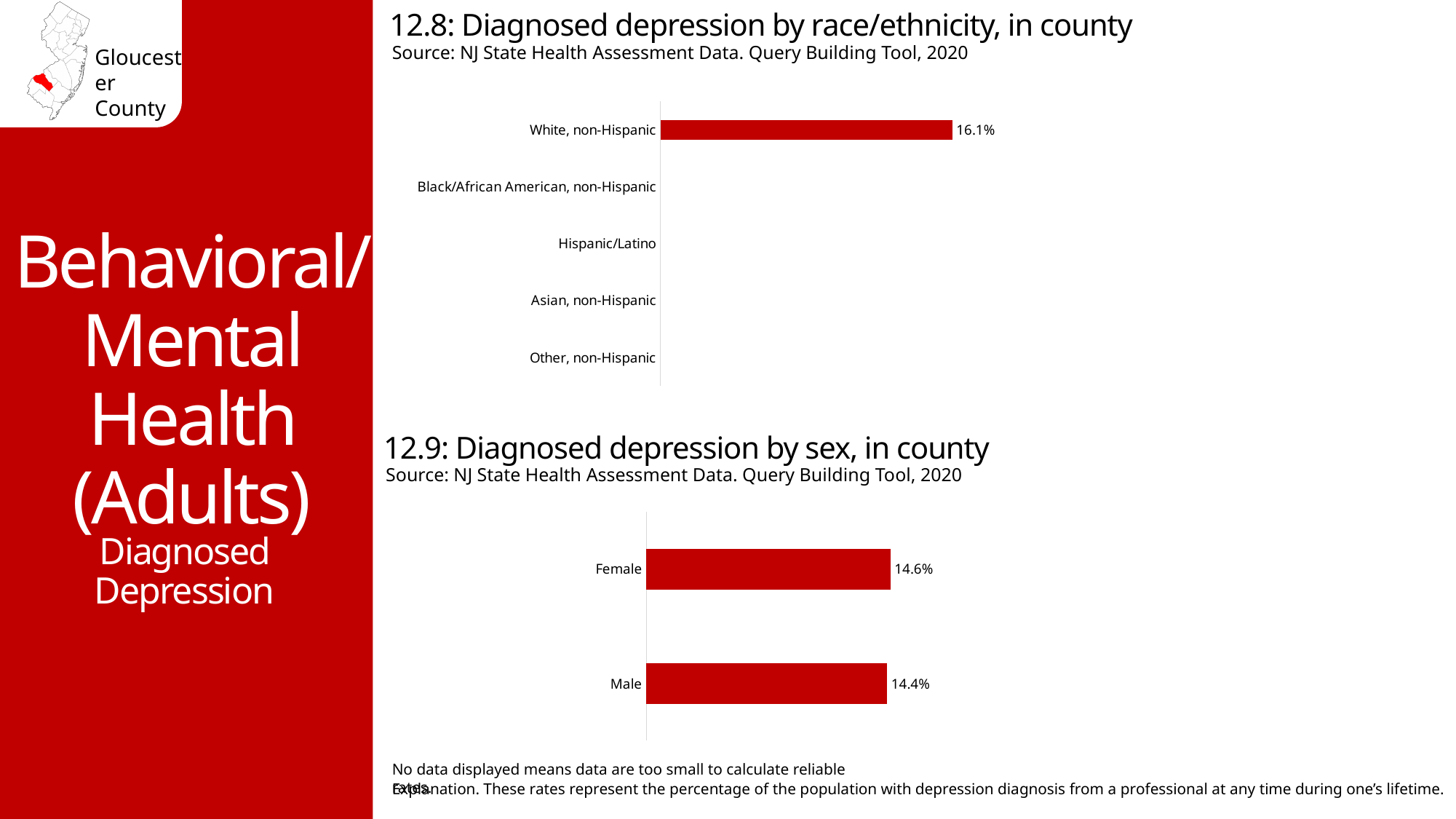
In the chart '12.9: Diagnosed depression by sex, in county', what is the value for Female? 14.6% In the chart '12.9: Diagnosed depression by sex, in county', what is the difference between the Female and Male values? 0.2% In the chart '12.9: Diagnosed depression by sex, in county', what is the value for Male? 14.4% In the chart '12.8: Diagnosed depression by race/ethnicity, in county', how many race/ethnicity categories are listed on the axis? 5 In the chart '12.9: Diagnosed depression by sex, in county', which category has the higher value? Female What kind of chart is '12.8: Diagnosed depression by race/ethnicity, in county'? Bar chart In the chart '12.9: Diagnosed depression by sex, in county', which category has the lower value? Male In the chart '12.9: Diagnosed depression by sex, in county', how many categories are shown? 2 In the chart '12.8: Diagnosed depression by race/ethnicity, in county', what is the value for White, non-Hispanic? 16.1% In the chart '12.8: Diagnosed depression by race/ethnicity, in county', which category is the only one with a bar displayed? White, non-Hispanic What kind of chart is '12.9: Diagnosed depression by sex, in county'? Bar chart What is the source cited for the chart '12.9: Diagnosed depression by sex, in county'? NJ State Health Assessment Data. Query Building Tool, 2020